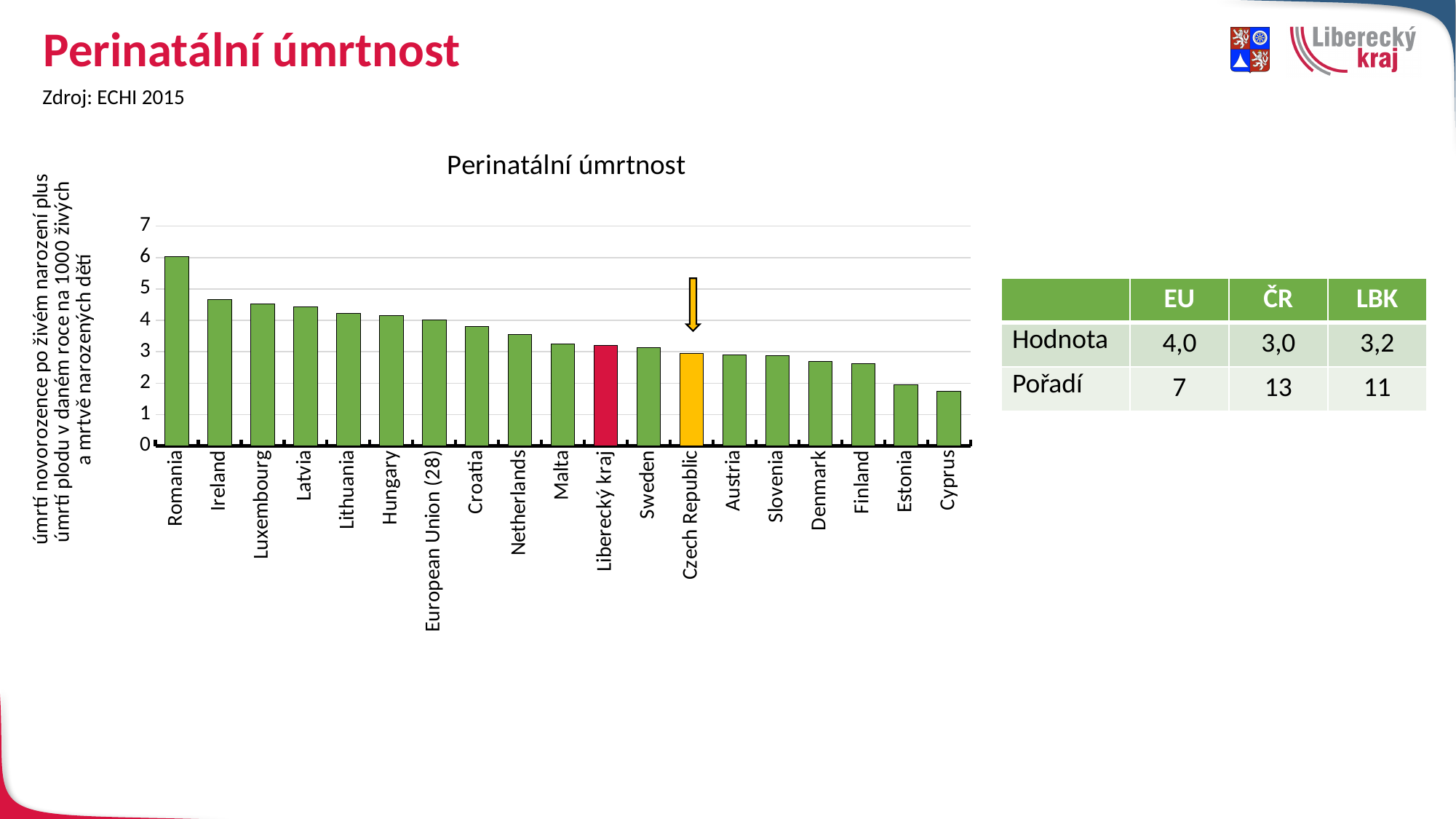
Which category has the lowest value in the chart? Cyprus How many countries/regions are shown on the x axis of the chart? 19 What is the title of the chart? Perinatální úmrtnost Is the value for Cyprus greater or less than 2? less Is the value for Romania greater or less than 5? greater Do the values rise or fall from left to right along the x axis? fall What kind of chart is shown on the slide? bar chart Which category has the highest value in the chart? Romania Which is larger, the value for Latvia or the value for Malta? Latvia What colour is the bar for Liberecký kraj? red Is the value for Denmark greater or less than 3? less Which is larger, the value for Romania or the value for Ireland? Romania